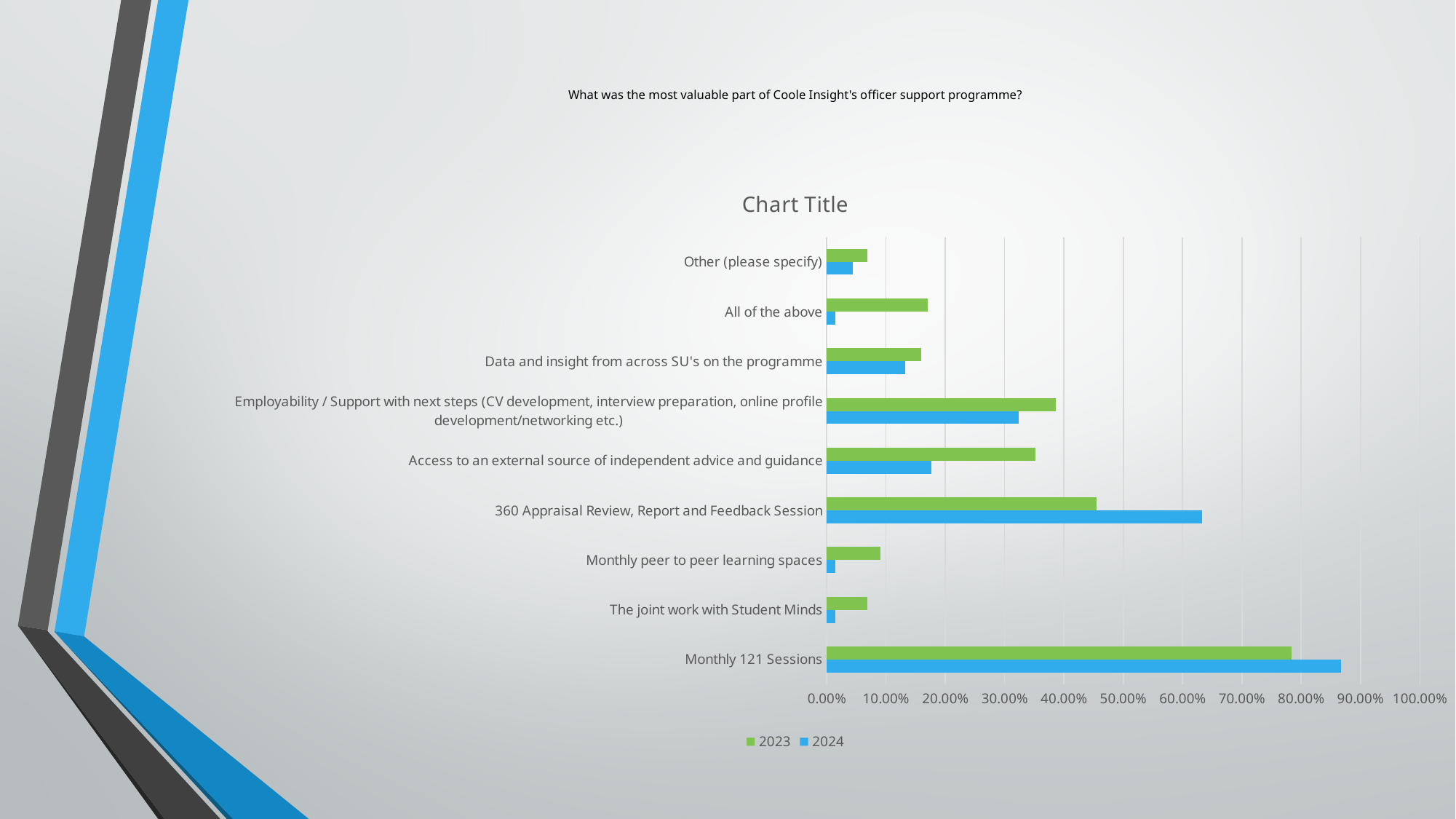
Which category has the highest value for the 2023 series? Monthly 121 Sessions Is the 2024 value for Monthly 121 Sessions greater or less than 80.00%? greater Is the 2024 value for 360 Appraisal Review, Report and Feedback Session greater or less than 60.00%? greater Which category has the highest value for the 2024 series? Monthly 121 Sessions For Access to an external source of independent advice and guidance, which series has the larger value, 2023 or 2024? 2023 For 360 Appraisal Review, Report and Feedback Session, which series has the larger value, 2023 or 2024? 2024 Is the 2023 value for 360 Appraisal Review, Report and Feedback Session greater or less than 50.00%? less How many series does the legend list? 2 How many categories are plotted on the chart? 9 What kind of chart is shown on the slide? Bar chart Which colour represents the 2024 series in the legend? Blue